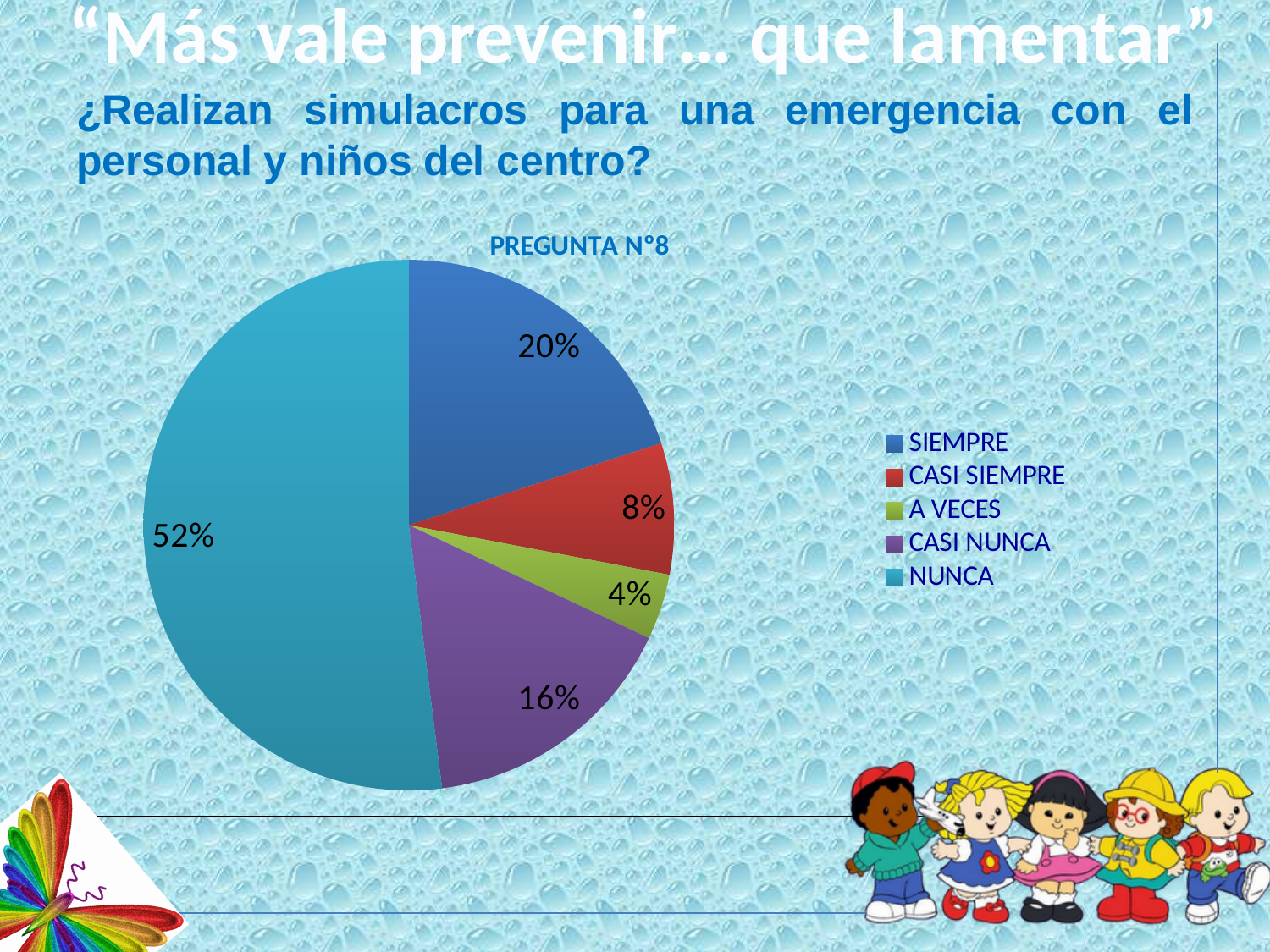
Which is larger, the share for CASI NUNCA or the share for CASI SIEMPRE? CASI NUNCA What is the difference in percentage points between NUNCA and SIEMPRE? 32 Which category has the smallest share of the pie? A VECES What percentage of the pie is NUNCA? 52% What percentage of the pie is SIEMPRE? 20% How many categories does the legend list? 5 What percentage of the pie is CASI SIEMPRE? 8% Which category has the largest share of the pie? NUNCA What percentage of the pie is CASI NUNCA? 16% What kind of chart is shown on the slide? pie chart What percentage of the pie is A VECES? 4% What is the chart's title? PREGUNTA N°8